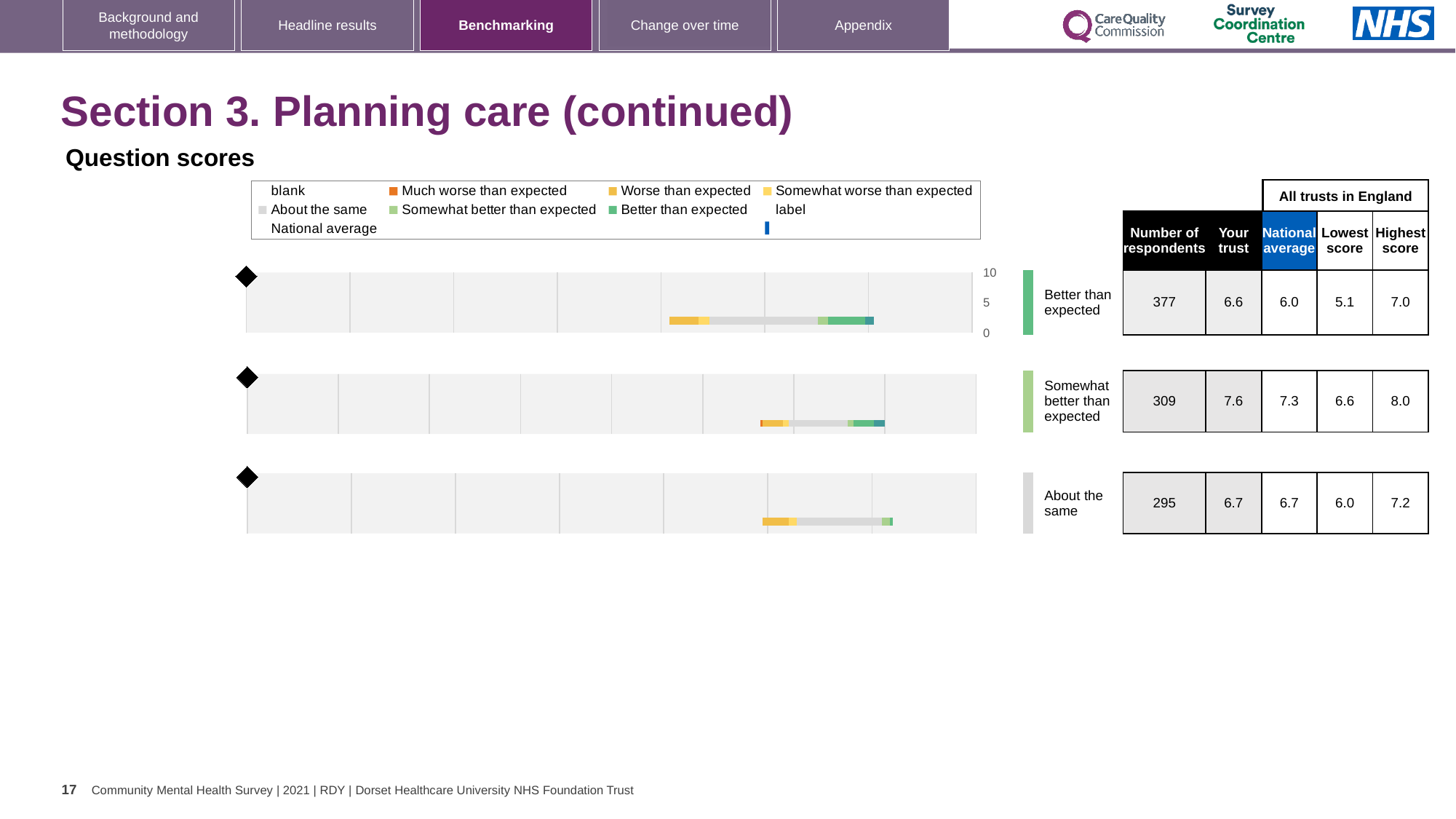
What is the maximum value shown on the vertical axis of the top chart? 10 For the middle chart (rated 'Somewhat better than expected'), what is the highest score among all trusts in England? 8.0 For the top chart (rated 'Better than expected'), what is the number of respondents? 377 Which of the three charts has the highest 'Your trust' score? Somewhat better than expected (middle chart) For the top chart (rated 'Better than expected'), which is larger: the 'Your trust' score or the national average? Your trust What type of chart is used to show the question scores on this slide? bar chart How many question score charts are shown on the slide? 3 Which of the three charts has the lowest number of respondents? About the same (bottom chart) For the top chart (rated 'Better than expected'), what is the lowest score among all trusts in England? 5.1 For the middle chart (rated 'Somewhat better than expected'), what is the difference between the 'Your trust' score and the national average? 0.3 For the middle chart (rated 'Somewhat better than expected'), what is the 'Your trust' score? 7.6 For the bottom chart (rated 'About the same'), what is the national average score? 6.7